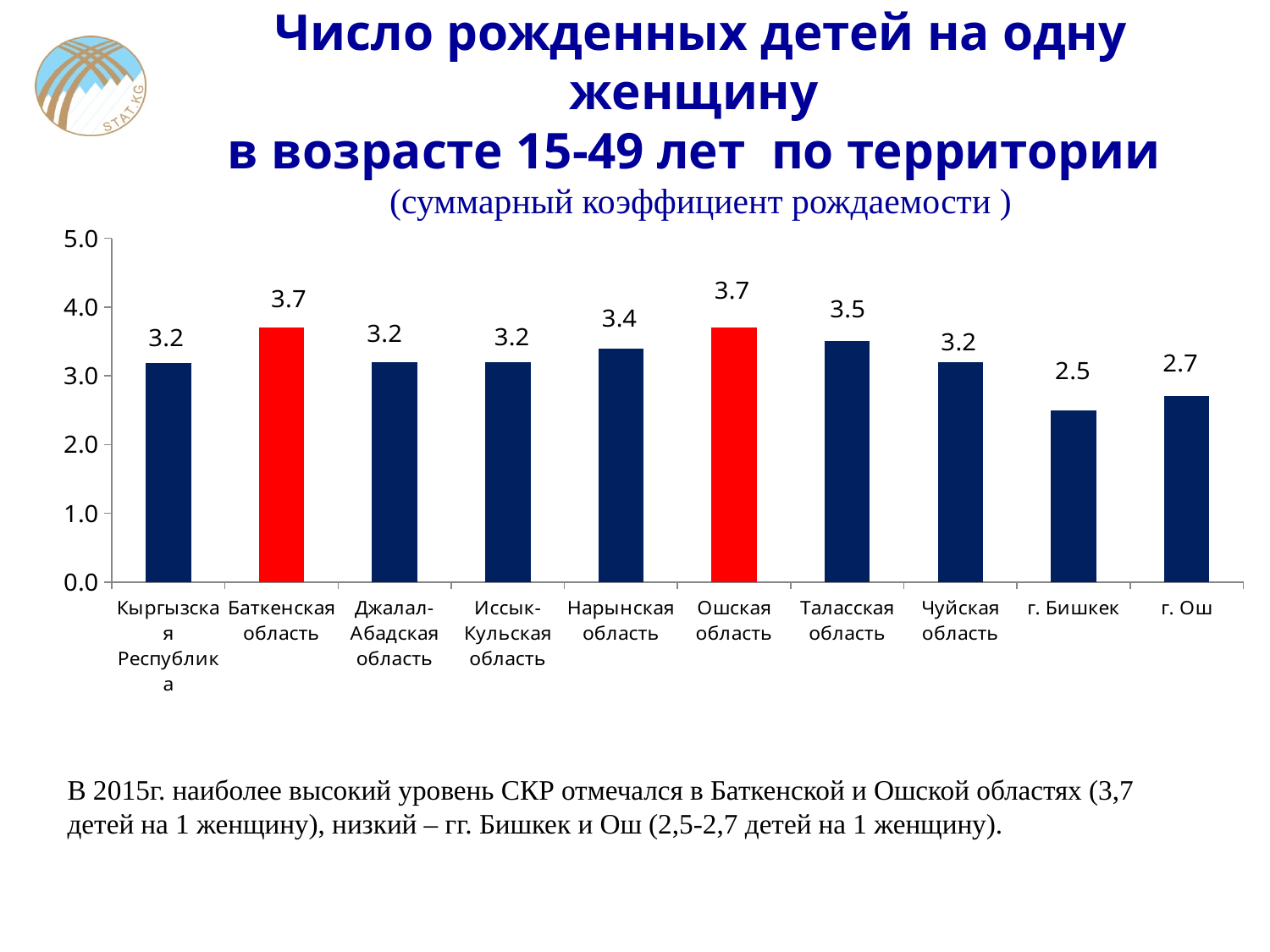
What is the value for г. Бишкек? 2.5 Which two bars are coloured red? Баткенская область and Ошская область Which two categories share the highest value? Баткенская область and Ошская область How many categories are shown on the x axis? 10 What is the value for г. Ош? 2.7 Which is larger, the value for Нарынская область or the value for г. Ош? Нарынская область What is the value for Таласская область? 3.5 What is the difference between the values for Таласская область and Чуйская область? 0.3 What is the difference between the values for Баткенская область and г. Бишкек? 1.2 What is the value for Нарынская область? 3.4 What kind of chart is shown on the slide? Bar chart Which category has the lowest value? г. Бишкек